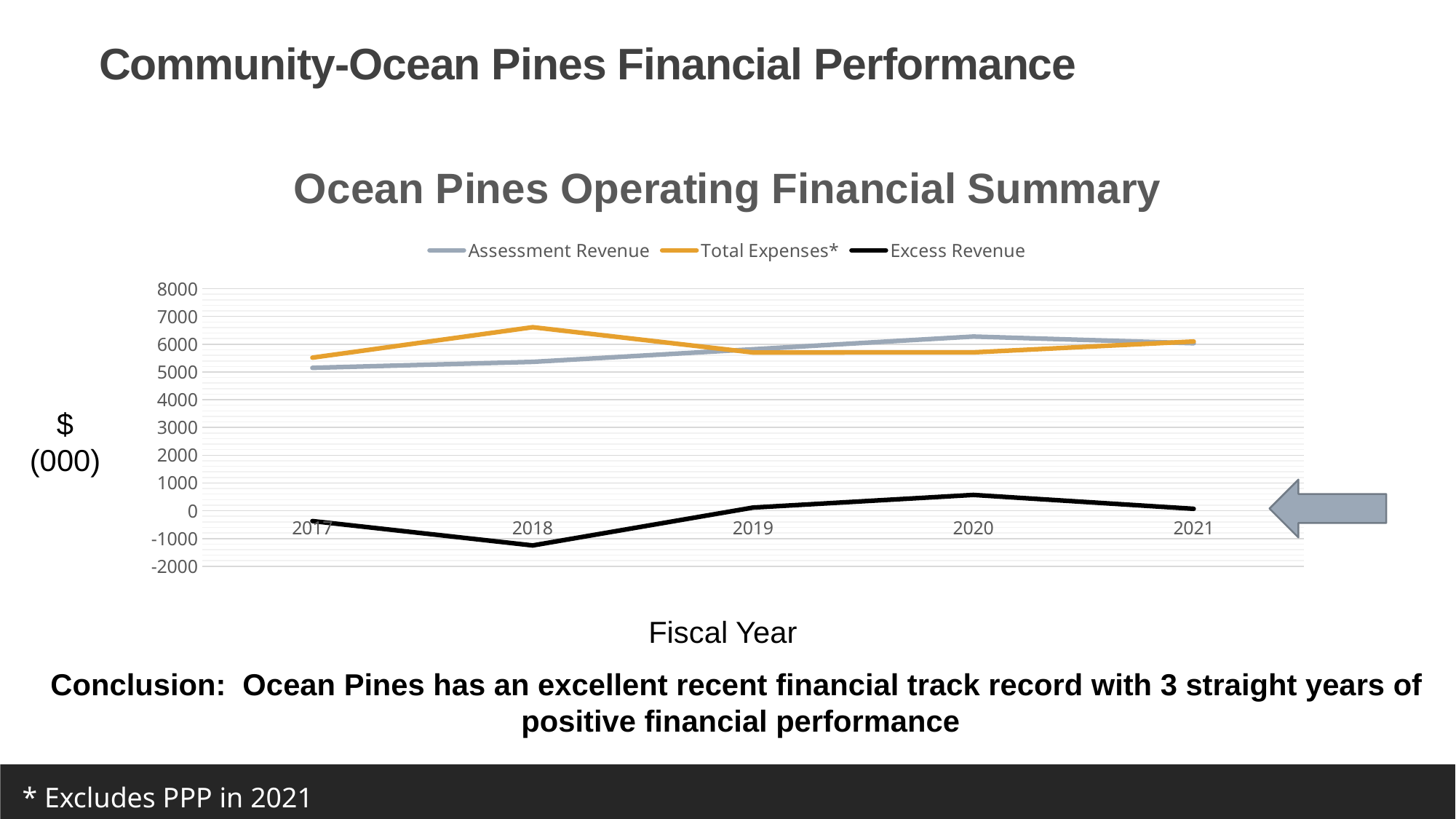
Is the value for Assessment Revenue in 2017 greater or less than 6000? less In which fiscal year is Excess Revenue lowest? 2018 How many fiscal years are plotted on the x axis of the chart? 5 Is the value for Excess Revenue in 2018 greater or less than 0? less In which fiscal year is Excess Revenue highest? 2020 How many series does the legend of the Ocean Pines Operating Financial Summary chart list? 3 In 2018, which is larger: Assessment Revenue or Total Expenses*? Total Expenses* Is the value for Total Expenses* in 2018 greater or less than 6000? greater What is the title of the x axis of the chart? Fiscal Year In 2020, which is larger: Assessment Revenue or Total Expenses*? Assessment Revenue In which fiscal year is Total Expenses* highest? 2018 What kind of chart is the Ocean Pines Operating Financial Summary? line chart